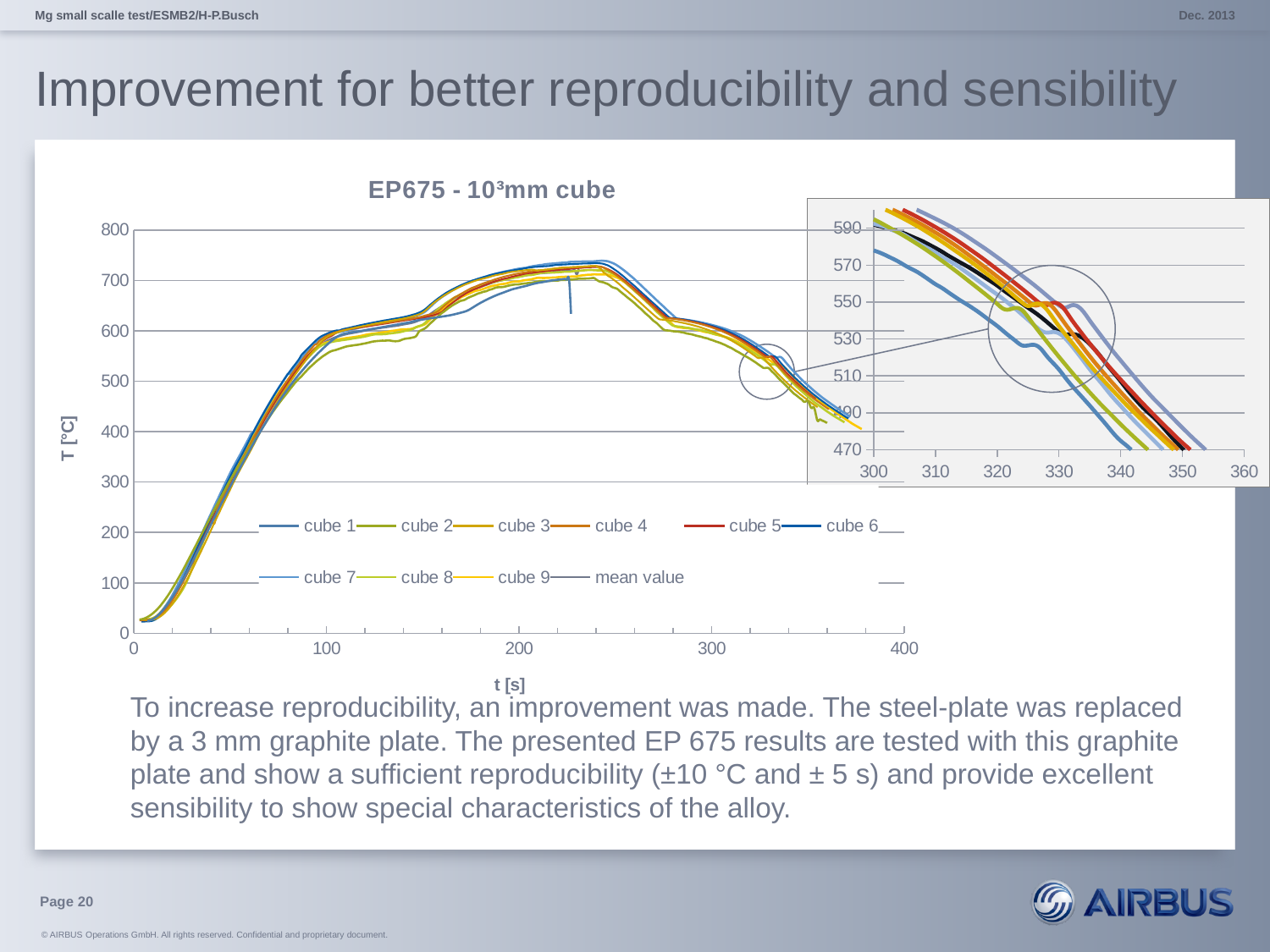
In the main chart, is the peak temperature reached by the cube curves greater or less than 600? greater In the main chart, is the temperature of the cube curves at t = 50 s greater or less than 200? greater In the main chart, do the temperature curves rise or fall between t = 250 s and t = 350 s? fall In the main chart, is the temperature of the cube curves at t = 50 s greater or less than 400? less What kind of chart is shown on the slide? line chart In the inset (zoomed) chart, do the curves rise or fall from t = 300 s to t = 350 s? fall How many series does the legend of the main chart list? 10 What is the highest value shown on the x axis of the inset (zoomed) chart? 360 In the main chart, do the temperature curves rise or fall between t = 0 s and t = 100 s? rise What is the title of the main chart? EP675 - 10³mm cube What is the label of the y axis of the main chart? T [°C]